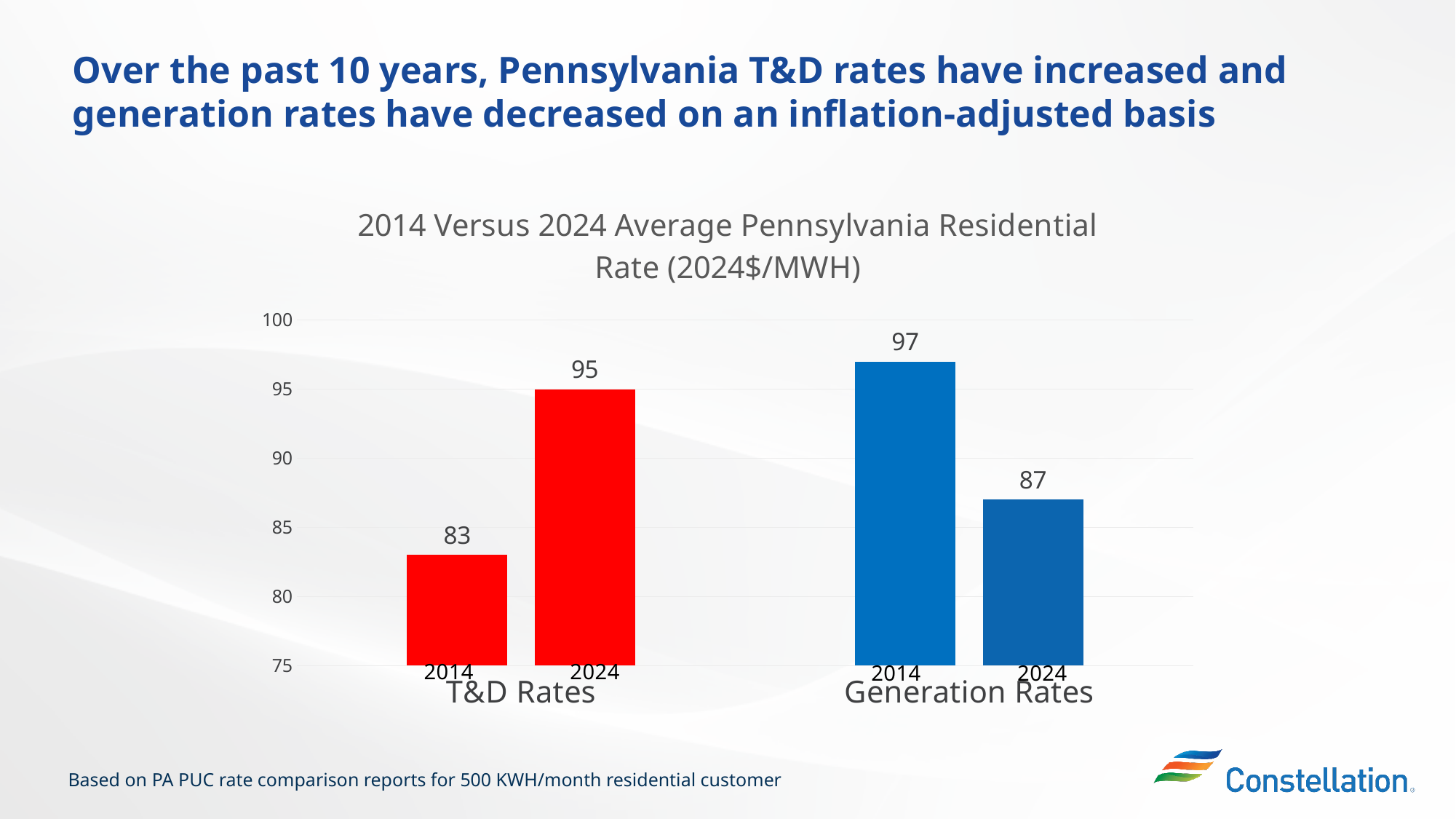
Which bar has the lowest value on the chart? 2014 T&D Rates What type of chart is shown on the slide? Bar chart What is the 2014 Generation rate shown on the chart? 97 What is the 2024 Generation rate shown on the chart? 87 What is the 2014 T&D rate shown on the chart? 83 How many bars are plotted on the chart? 4 By how much did the T&D rate increase from 2014 to 2024? 12 Which bar has the highest value on the chart? 2014 Generation Rates By how much did the Generation rate decrease from 2014 to 2024? 10 Which is larger, the 2024 T&D rate or the 2024 Generation rate? 2024 T&D rate What is the title of the chart? 2014 Versus 2024 Average Pennsylvania Residential Rate (2024$/MWH) What is the 2024 T&D rate shown on the chart? 95